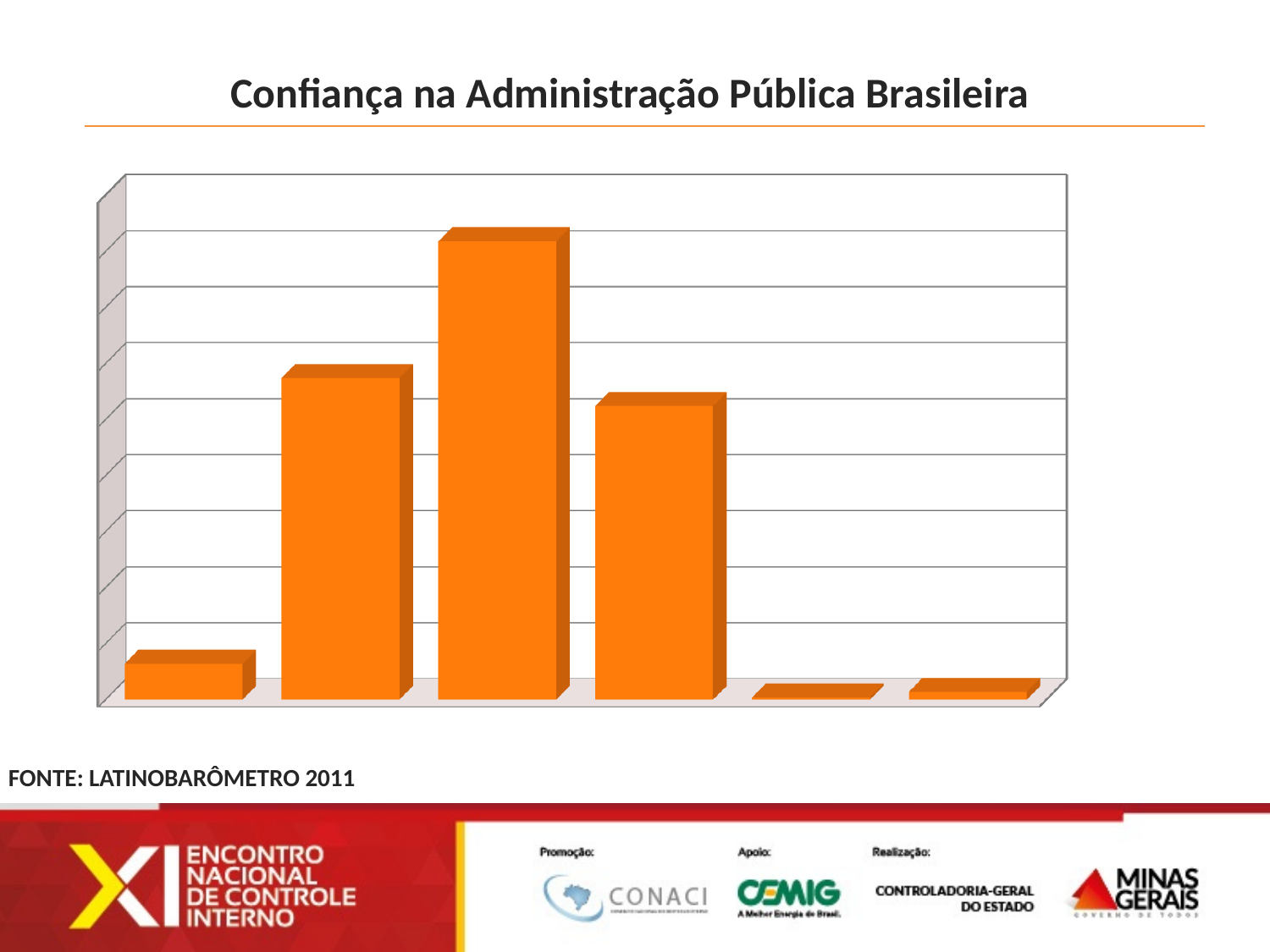
What kind of chart is shown on the slide? bar chart What colour are the bars in the chart? orange How many bars are plotted in the chart? 6 Which is taller, the first bar from the left or the fourth bar from the left? the fourth bar Counting from the left, which bar is the tallest in the chart? the third bar What is the title of the chart on the slide? Confiança na Administração Pública Brasileira Which is taller, the second bar from the left or the fourth bar from the left? the second bar What source is cited below the chart? LATINOBARÔMETRO 2011